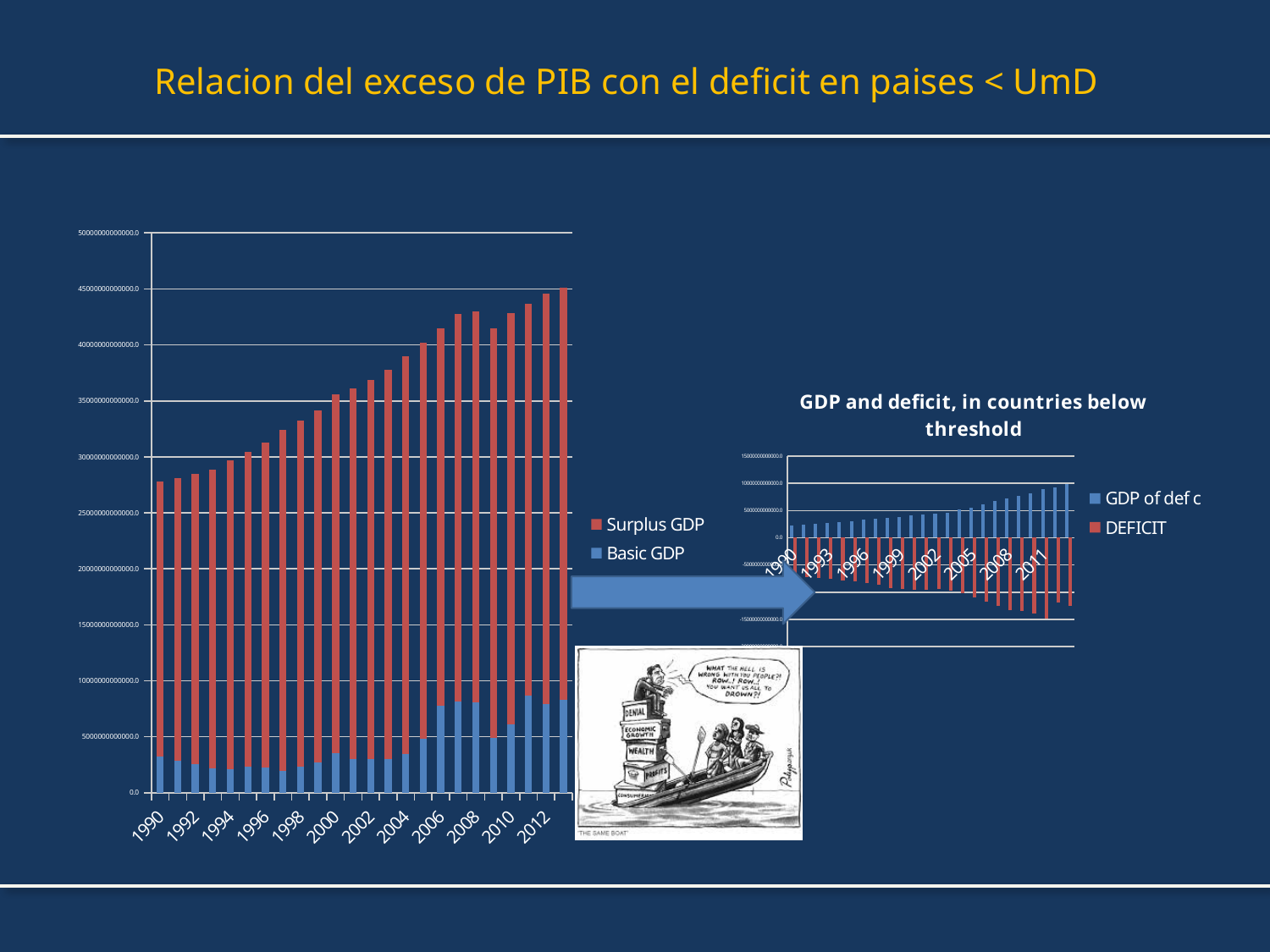
What kind of chart is the large chart on the left of the slide? bar chart In the left chart, is the total bar for 2012 larger or smaller than the total bar for 1990? larger In the left chart, which colour represents Basic GDP? blue In the left chart, do the total bar heights generally rise or fall from 1990 to 2012? rise What are the two series named in the legend of the left chart? Surplus GDP and Basic GDP How many series does the legend of the chart titled 'GDP and deficit, in countries below threshold' list? 2 In the chart titled 'GDP and deficit, in countries below threshold', do the blue GDP bars rise or fall from 1990 to 2011? rise In the chart titled 'GDP and deficit, in countries below threshold', are the DEFICIT bars plotted above or below zero? below How many series does the legend of the left chart list? 2 What is the title of the smaller chart on the right of the slide? GDP and deficit, in countries below threshold In the left chart, which year has the lowest total bar? 1990 How many year labels are shown on the x axis of the left chart? 12